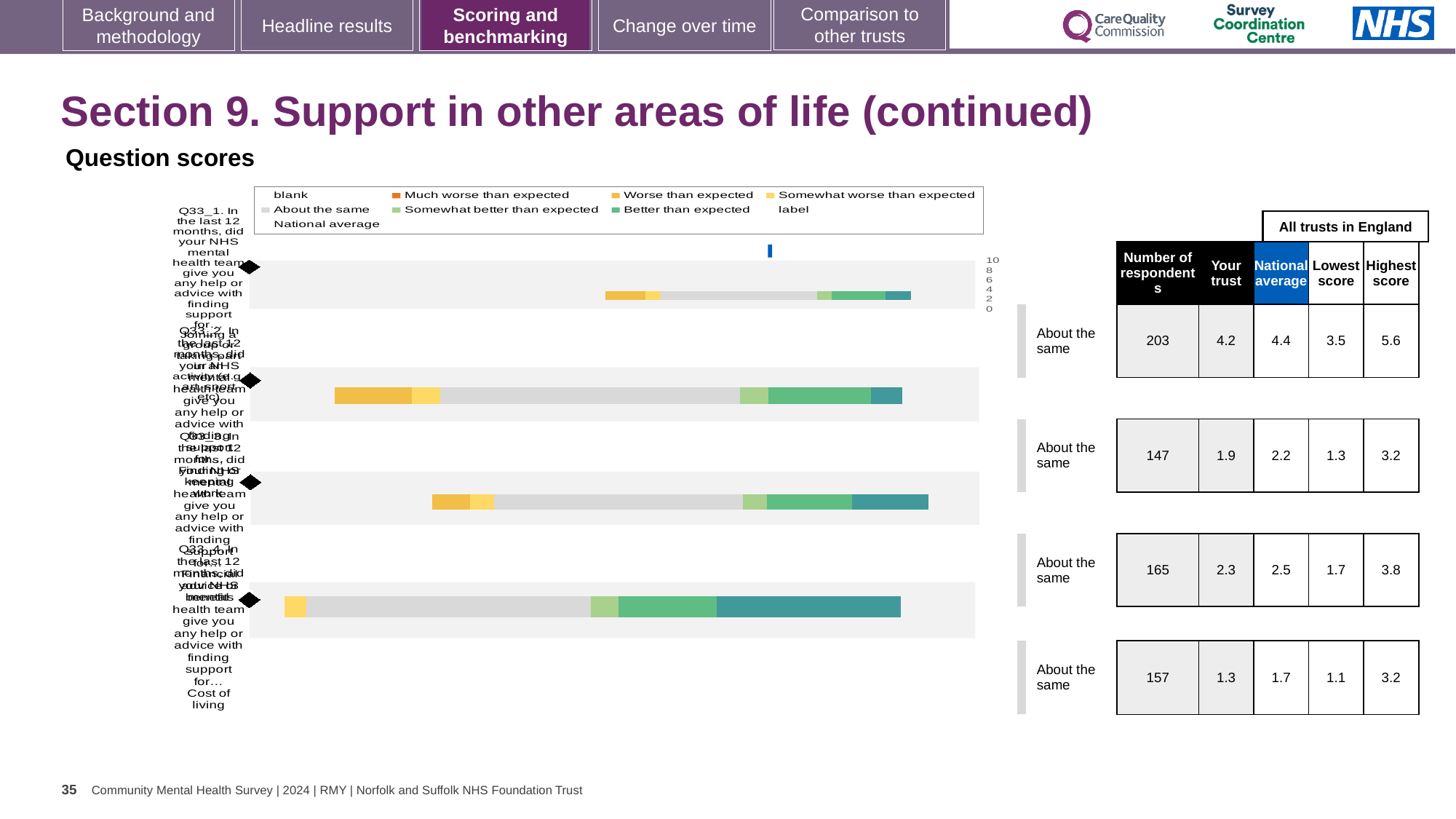
In the table beside the chart, what is the difference between the highest score and the lowest score for the first question row (Q33_1)? 2.1 In the table beside the chart, which is larger for the first question row (Q33_1): the 'Your trust' score or the national average? National average In the table beside the chart, what is the 'Your trust' score for the first question row (Q33_1)? 4.2 In the table beside the chart, which question row has the highest 'Your trust' score? Q33_1 In the table beside the chart, what is the national average for the last question row (Q33_4, Cost of living)? 1.7 In the table beside the chart, which question row has the fewest respondents? Q33_2 In the table beside the chart, how many respondents are listed for the first question row (Q33_1)? 203 What kind of chart is shown under 'Question scores'? bar chart What is the first entry in the legend of the 'Question scores' chart? blank How many entries does the legend of the 'Question scores' chart list? 9 How many question bars are plotted in the 'Question scores' chart? 4